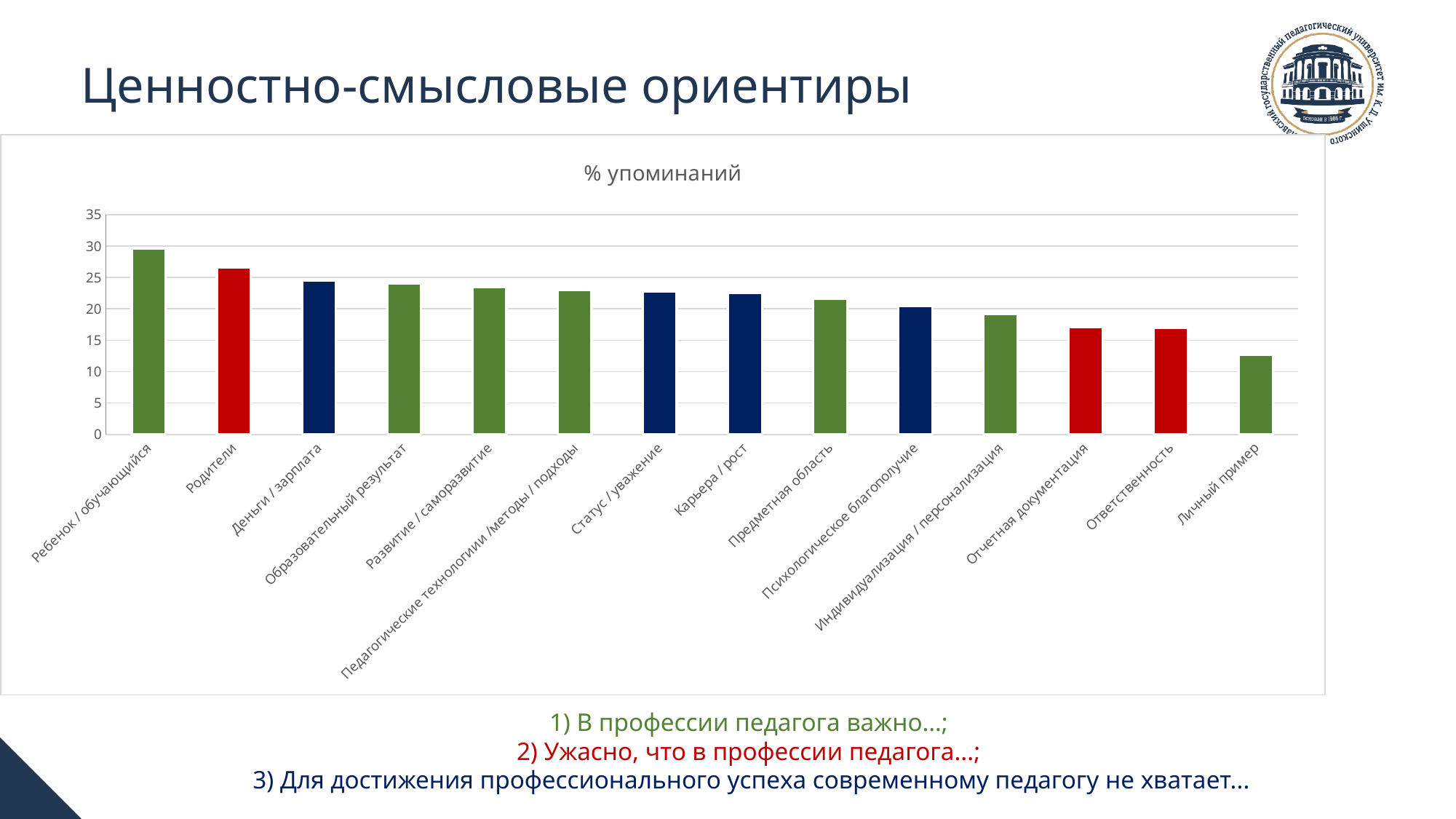
Is the value for Личный пример greater or less than 15? less Do the values rise or fall from left to right along the x axis? fall Is the value for Родители greater or less than 25? greater How many different bar colours are used in the chart? 3 Which category has the highest value? Ребенок / обучающийся Is the value for Ребенок / обучающийся greater or less than 25? greater How many categories are plotted in the chart? 14 Which category has the lowest value? Личный пример What is the title of the chart? % упоминаний Which is larger, the value for Родители or the value for Деньги / зарплата? Родители What kind of chart is shown on the slide? bar chart